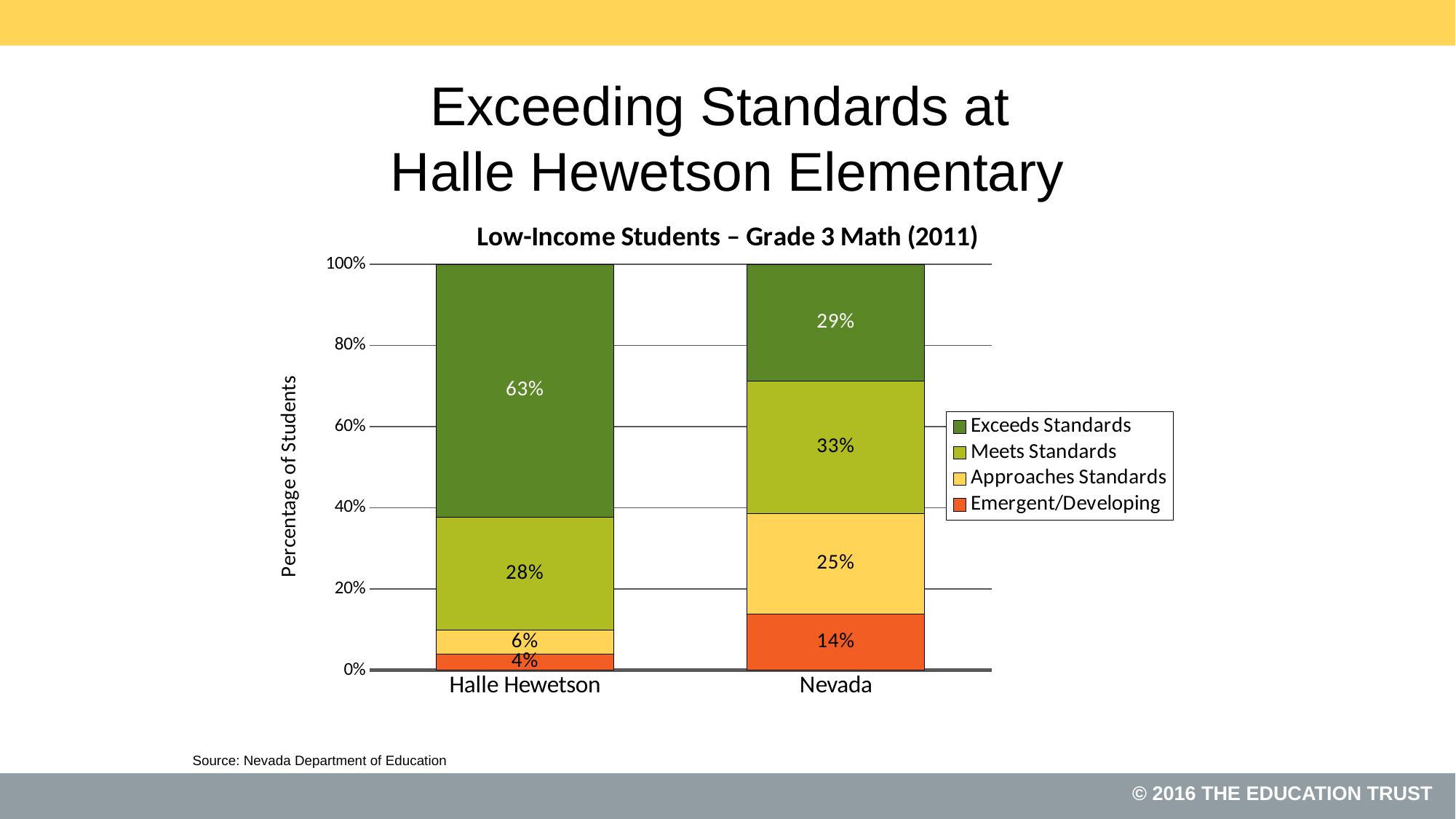
Which category has the larger Exceeds Standards share, Halle Hewetson or Nevada? Halle Hewetson What kind of chart is shown on the slide? Stacked bar chart What is the difference in the Emergent/Developing percentage between Nevada and Halle Hewetson? 10 percentage points What is the difference in the Exceeds Standards percentage between Halle Hewetson and Nevada? 34 percentage points What percentage of low-income students at Halle Hewetson are in the Approaches Standards category? 6% What percentage of low-income students in Nevada are in the Emergent/Developing category? 14% What percentage of low-income students at Halle Hewetson exceed standards in Grade 3 Math? 63% Which segment is the smallest in the Halle Hewetson bar? Emergent/Developing How many series does the legend list? 4 What is the title of the chart? Low-Income Students – Grade 3 Math (2011) Which segment is the largest in the Nevada bar? Meets Standards What percentage of low-income students in Nevada meet standards? 33%